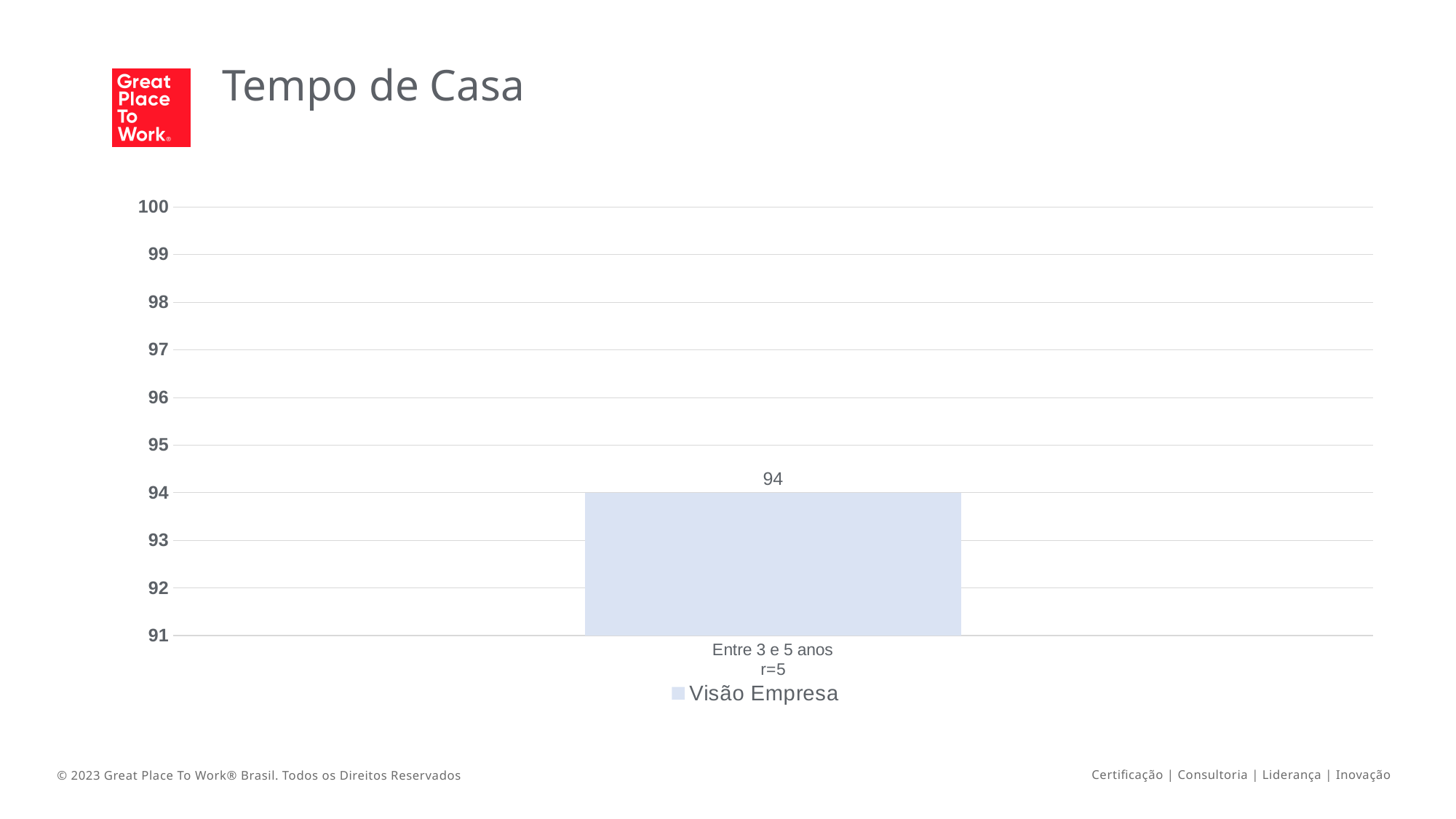
What is the category label of the single bar in the chart? Entre 3 e 5 anos What is the lowest value shown on the y axis of the chart? 91 What is the value for "Entre 3 e 5 anos" in the Visão Empresa series? 94 What kind of chart is shown on the slide? bar chart Is the value for "Entre 3 e 5 anos" greater or less than 95? less What is the title of the slide containing the chart? Tempo de Casa What is the name of the series listed in the legend? Visão Empresa What is the highest value shown on the y axis of the chart? 100 How many series does the legend list? 1 Is the value for "Entre 3 e 5 anos" greater or less than 92? greater How many categories are shown on the x axis of the chart? 1